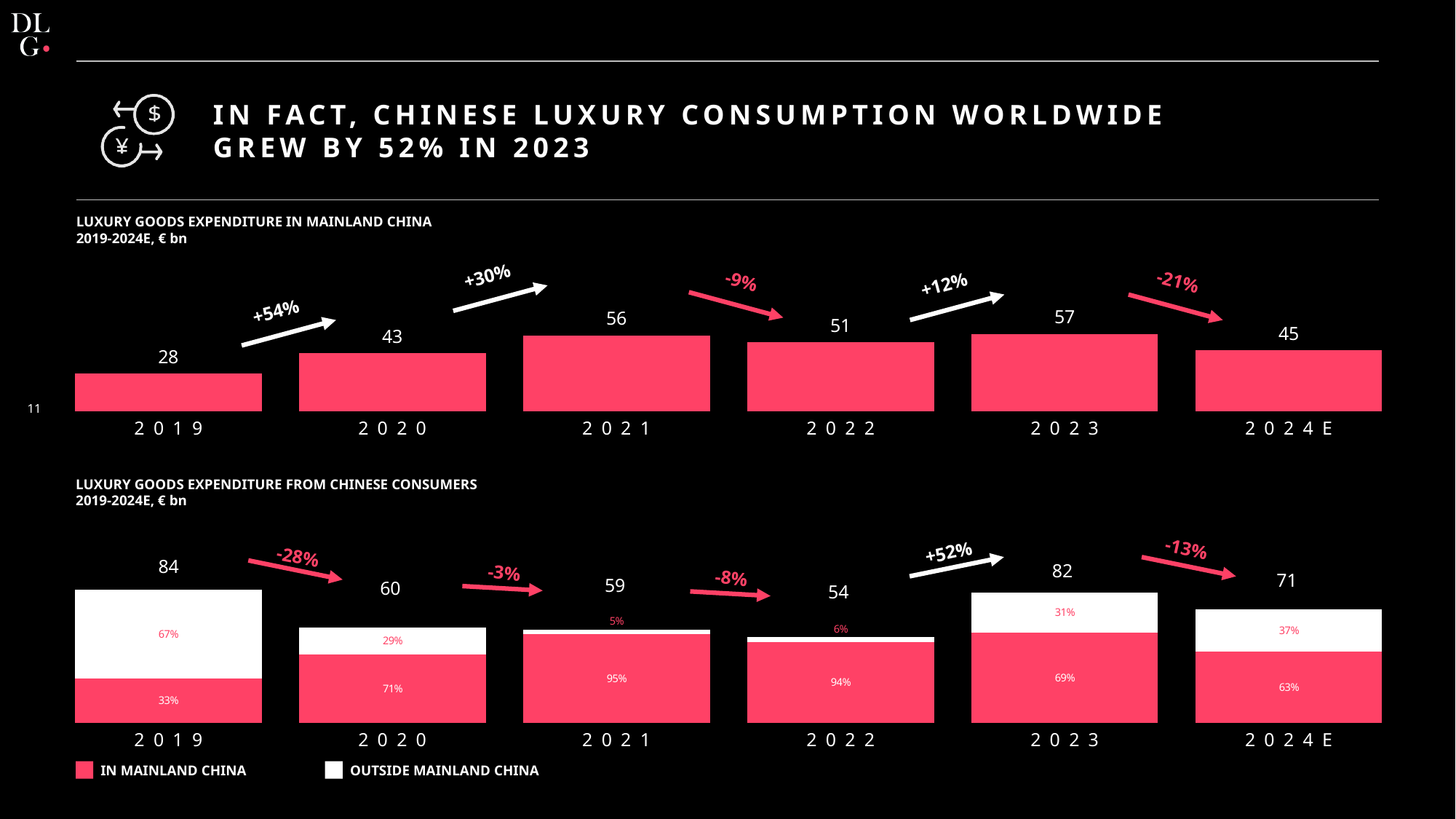
In the 'Luxury goods expenditure in mainland China' chart, what is the value for 2021? 56 In the 'Luxury goods expenditure in mainland China' chart, which year has the lowest value? 2019 In the 'Luxury goods expenditure from Chinese consumers' chart, what is the total for 2023? 82 What type of chart is the 'Luxury goods expenditure in mainland China' chart? bar chart In the 'Luxury goods expenditure in mainland China' chart, what is the difference between the 2023 and 2024E values? 12 How many series does the legend of the 'Luxury goods expenditure from Chinese consumers' chart list? 2 In the 'Luxury goods expenditure in mainland China' chart, what percentage change is shown between 2019 and 2020? +54% In the 'Luxury goods expenditure from Chinese consumers' chart, is the total for 2022 larger or smaller than the total for 2020? smaller In the 'Luxury goods expenditure in mainland China' chart, which year has the highest value? 2023 In the 'Luxury goods expenditure from Chinese consumers' chart, what share of 2019 expenditure was outside mainland China? 67% In the 'Luxury goods expenditure from Chinese consumers' chart, what share of 2021 expenditure was in mainland China? 95% In the 'Luxury goods expenditure from Chinese consumers' chart, which year has the highest total? 2019